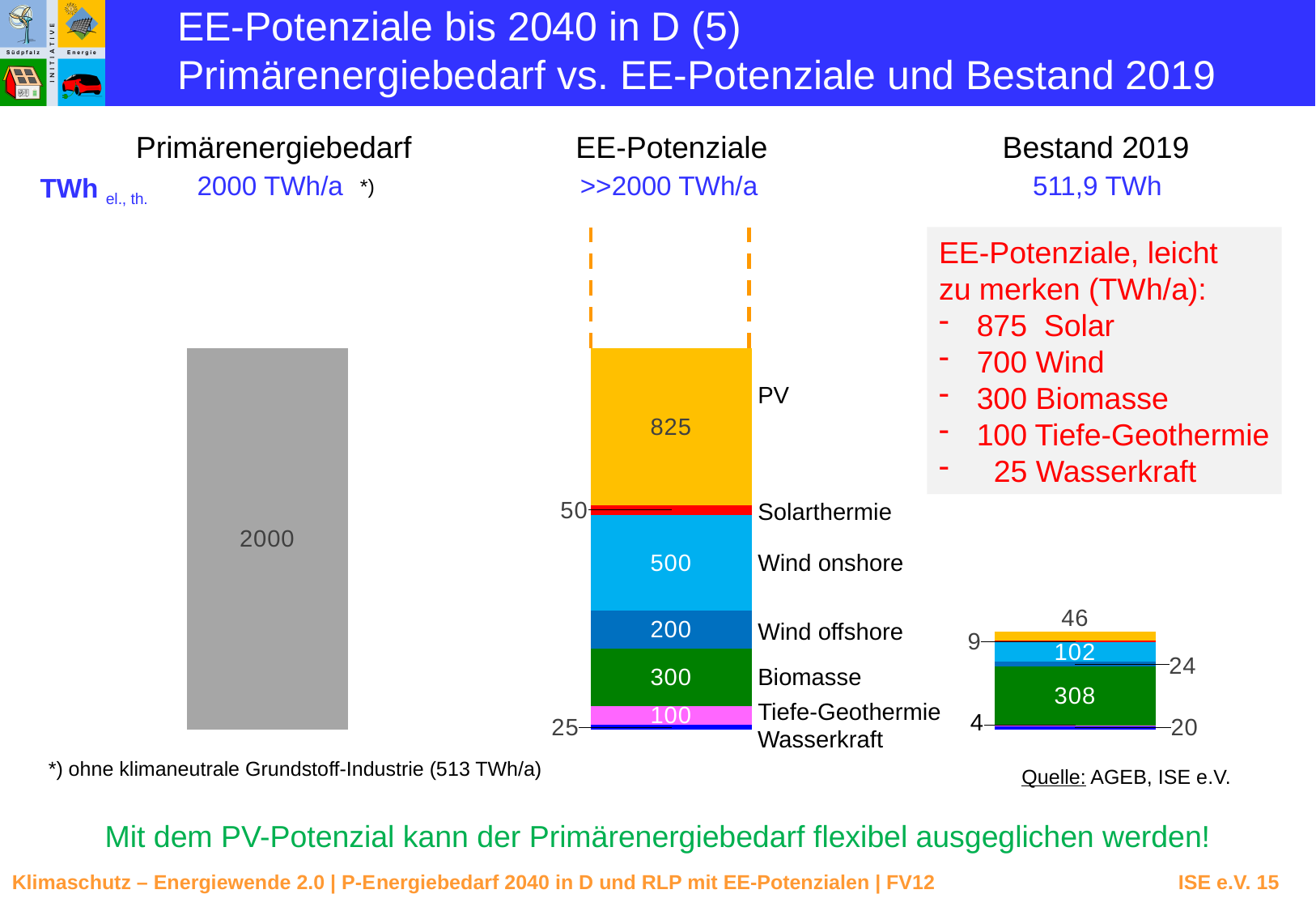
In the EE-Potenziale chart, what is the value for Wasserkraft? 25 In the Primärenergiebedarf chart, what value is printed on the bar? 2000 In the EE-Potenziale chart, what is the value for Wind onshore? 500 In the EE-Potenziale chart, what is the difference between Wind onshore and Wind offshore? 300 In the EE-Potenziale chart, what is the total of all segments in the stacked bar? 2000 In the EE-Potenziale chart, which is larger, Biomasse or Wind offshore? Biomasse In the EE-Potenziale chart, which segment is the smallest? Wasserkraft In the EE-Potenziale chart, which segment is the largest? PV In the EE-Potenziale chart, how many segments make up the stacked bar? 7 In the EE-Potenziale chart, what is the value for Wind offshore? 200 In the EE-Potenziale chart, what is the value for Tiefe-Geothermie? 100 In the EE-Potenziale chart, what is the value for PV? 825